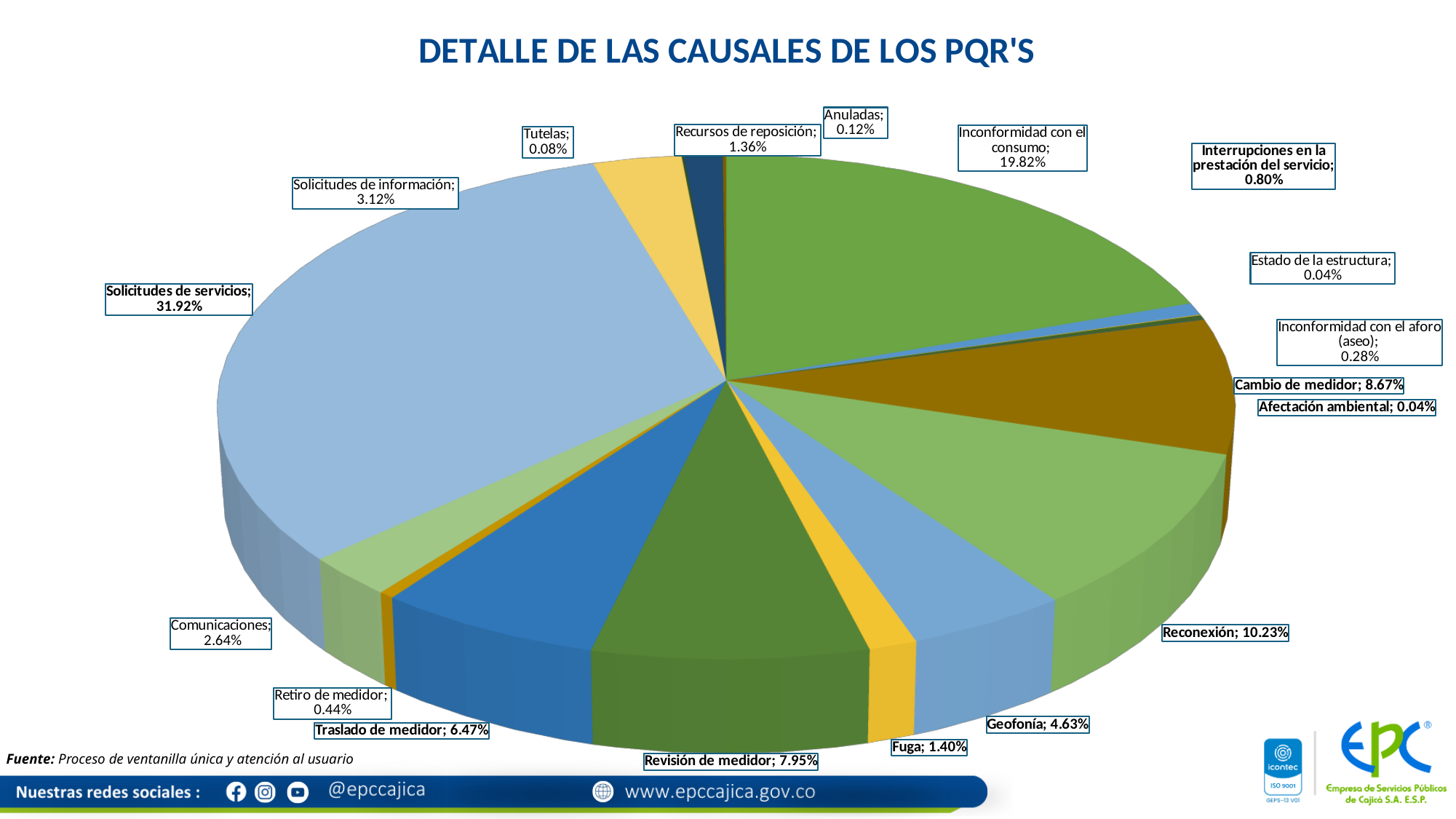
What percentage is shown for Geofonía? 4.63% Which is larger, the share for Traslado de medidor or the share for Geofonía? Traslado de medidor What percentage is shown for Inconformidad con el consumo? 19.82% What percentage is shown for Tutelas? 0.08% What is the difference between the shares of Cambio de medidor and Revisión de medidor? 0.72% What is the combined share of Solicitudes de servicios and Inconformidad con el consumo? 51.74% Which category has the largest share of the pie? Solicitudes de servicios What percentage is shown for Solicitudes de servicios? 31.92% What is the title of the chart? DETALLE DE LAS CAUSALES DE LOS PQR'S What percentage is shown for Reconexión? 10.23% What kind of chart is shown on the slide? Pie chart How many categories are shown in the pie chart? 18